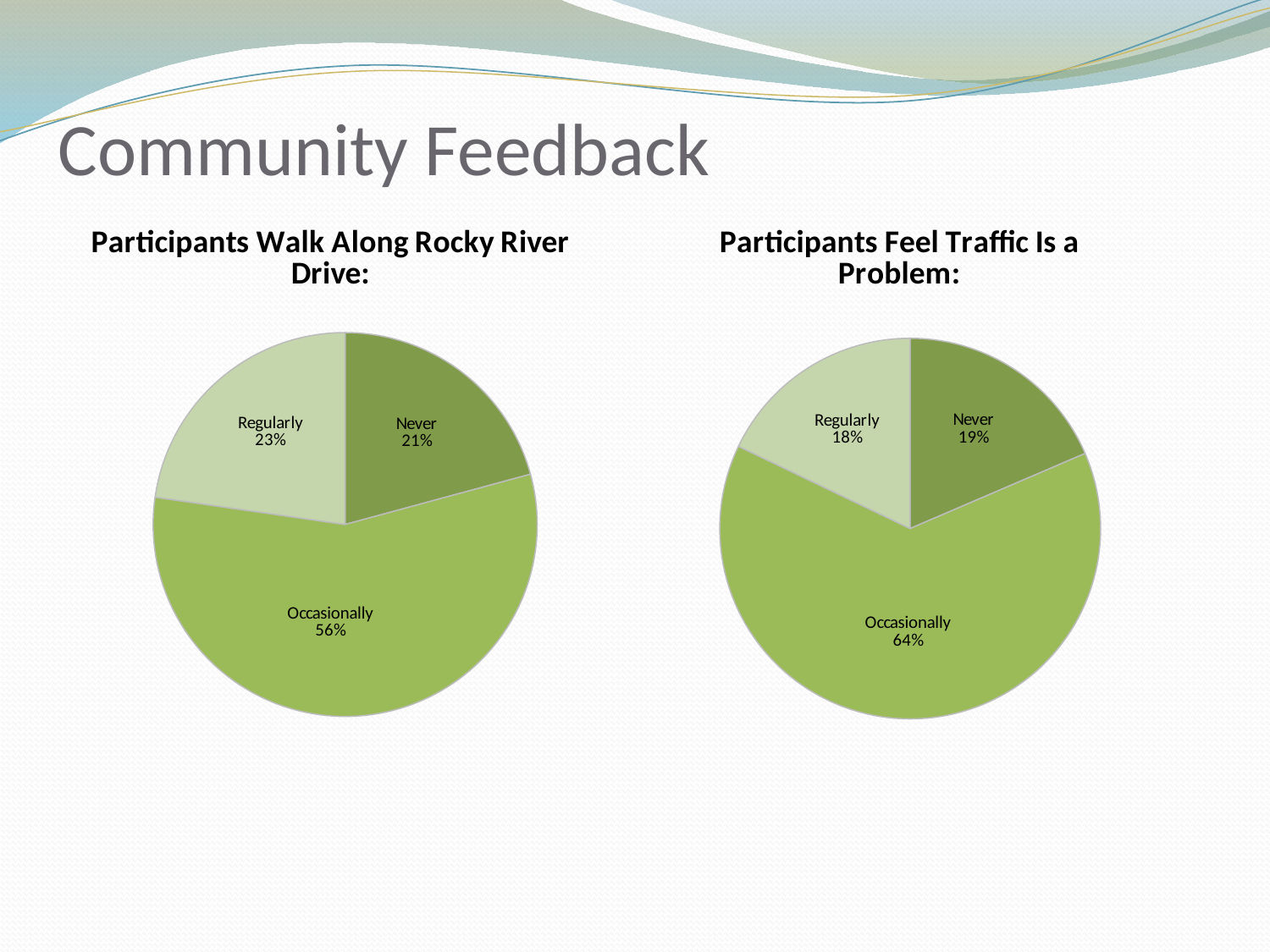
How many slices does the 'Participants Walk Along Rocky River Drive' chart have? 3 In the 'Participants Feel Traffic Is a Problem' chart, what share of participants answered Never? 19% In the 'Participants Walk Along Rocky River Drive' chart, what is the difference between the Occasionally and Regularly shares? 33% In the 'Participants Walk Along Rocky River Drive' chart, what share of participants answered Regularly? 23% In the 'Participants Walk Along Rocky River Drive' chart, which category has the largest slice? Occasionally What is the title of the chart on the left side of the slide? Participants Walk Along Rocky River Drive: In the 'Participants Walk Along Rocky River Drive' chart, what share of participants answered Occasionally? 56% In the 'Participants Feel Traffic Is a Problem' chart, what is the difference between the Never and Regularly shares? 1% In the 'Participants Feel Traffic Is a Problem' chart, which category has the smallest slice? Regularly In the 'Participants Feel Traffic Is a Problem' chart, what share of participants answered Occasionally? 64% What type of chart is used for 'Participants Feel Traffic Is a Problem'? Pie chart Which chart has the larger Occasionally share, 'Participants Walk Along Rocky River Drive' or 'Participants Feel Traffic Is a Problem'? Participants Feel Traffic Is a Problem